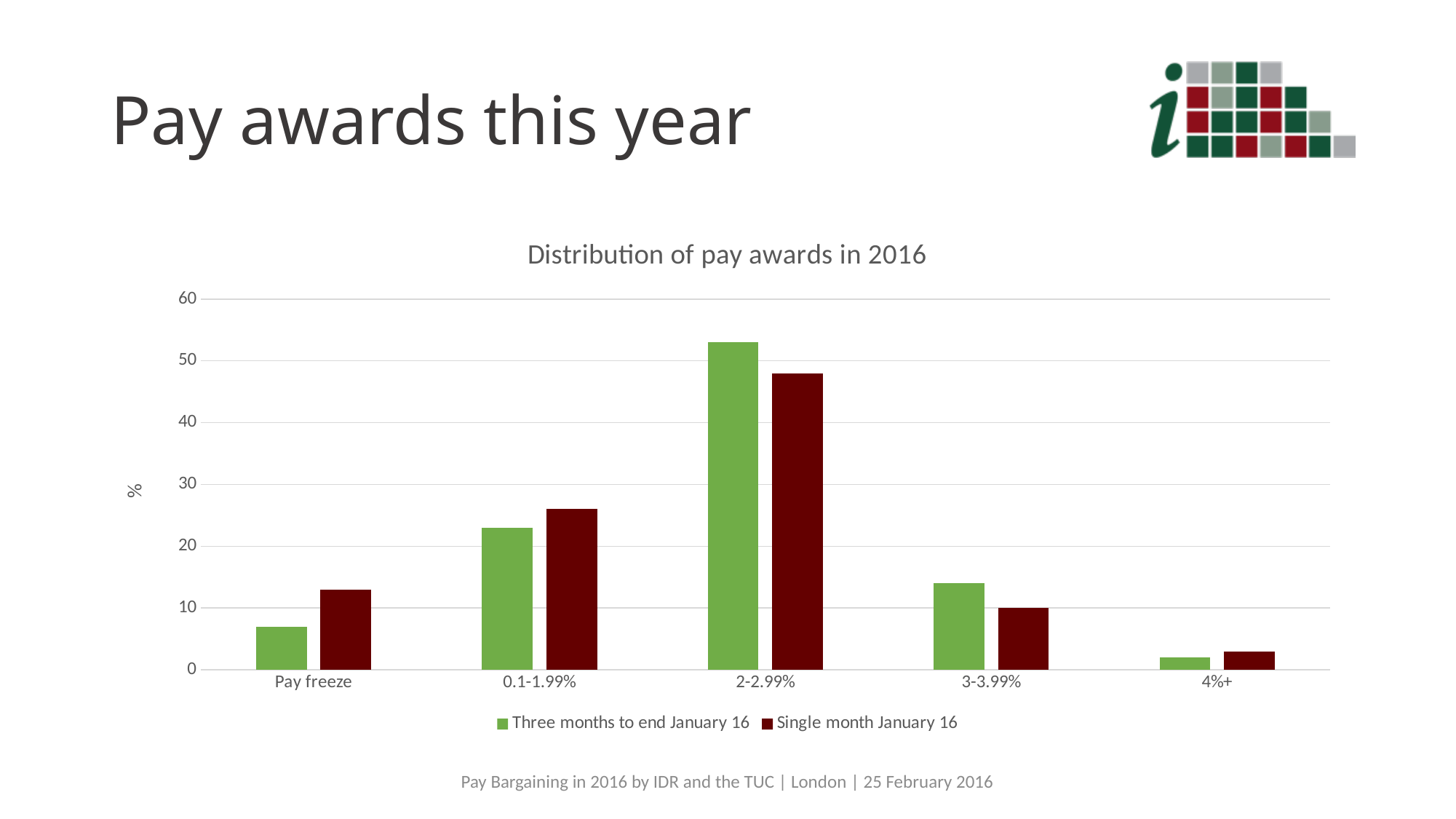
Which category has the highest value for the 'Three months to end January 16' series? 2-2.99% Is the value for Pay freeze in the 'Three months to end January 16' series greater or less than 10? less What is the title of the chart? Distribution of pay awards in 2016 What type of chart is shown on the slide? Bar chart How many pay award categories are shown on the x axis? 5 For the Pay freeze category, which series has the larger value? Single month January 16 Is the value for 0.1-1.99% in the 'Single month January 16' series greater or less than 20? greater Is the value for 2-2.99% in the 'Three months to end January 16' series greater or less than 50? greater Which category has the lowest value for the 'Single month January 16' series? 4%+ For the 3-3.99% category, which series has the larger value? Three months to end January 16 How many series does the legend list? 2